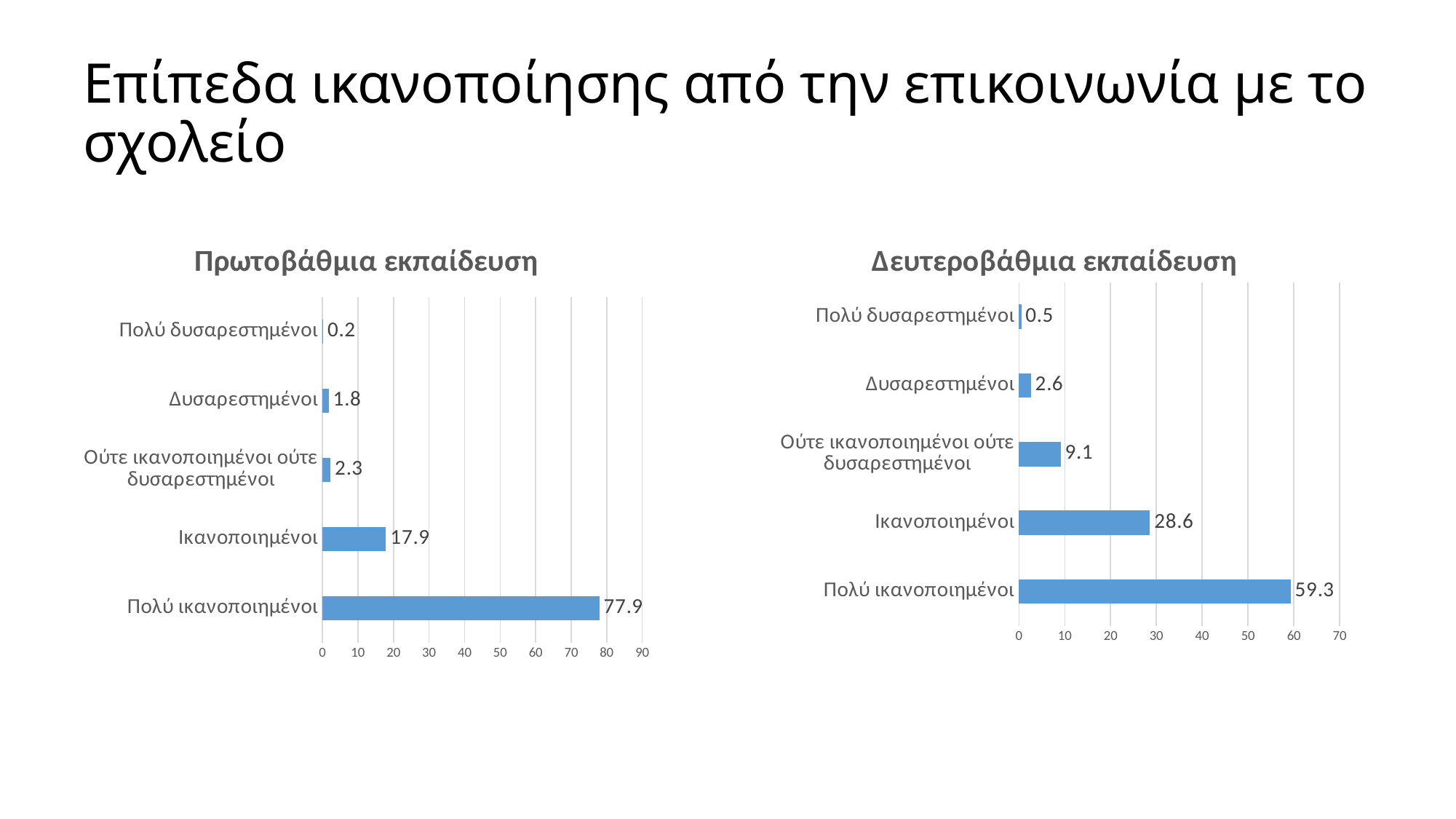
In the 'Δευτεροβάθμια εκπαίδευση' chart, what is the value for 'Ικανοποιημένοι'? 28.6 What is the title of the chart on the left of the slide? Πρωτοβάθμια εκπαίδευση How many categories does the 'Πρωτοβάθμια εκπαίδευση' chart show? 5 In the 'Δευτεροβάθμια εκπαίδευση' chart, which category has the highest value? Πολύ ικανοποιημένοι In the 'Πρωτοβάθμια εκπαίδευση' chart, what is the difference between 'Πολύ ικανοποιημένοι' and 'Ικανοποιημένοι'? 60 In the 'Πρωτοβάθμια εκπαίδευση' chart, which category has the lowest value? Πολύ δυσαρεστημένοι In the 'Δευτεροβάθμια εκπαίδευση' chart, is the value for 'Ικανοποιημένοι' greater or less than 20? greater What kind of chart is the 'Δευτεροβάθμια εκπαίδευση' chart? Bar chart In the 'Πρωτοβάθμια εκπαίδευση' chart, what is the value for 'Πολύ ικανοποιημένοι'? 77.9 In the 'Δευτεροβάθμια εκπαίδευση' chart, what is the difference between 'Πολύ ικανοποιημένοι' and 'Ικανοποιημένοι'? 30.7 Which is larger: 'Πολύ ικανοποιημένοι' in the 'Πρωτοβάθμια εκπαίδευση' chart or 'Πολύ ικανοποιημένοι' in the 'Δευτεροβάθμια εκπαίδευση' chart? Πρωτοβάθμια εκπαίδευση In the 'Δευτεροβάθμια εκπαίδευση' chart, what is the value for 'Ούτε ικανοποιημένοι ούτε δυσαρεστημένοι'? 9.1